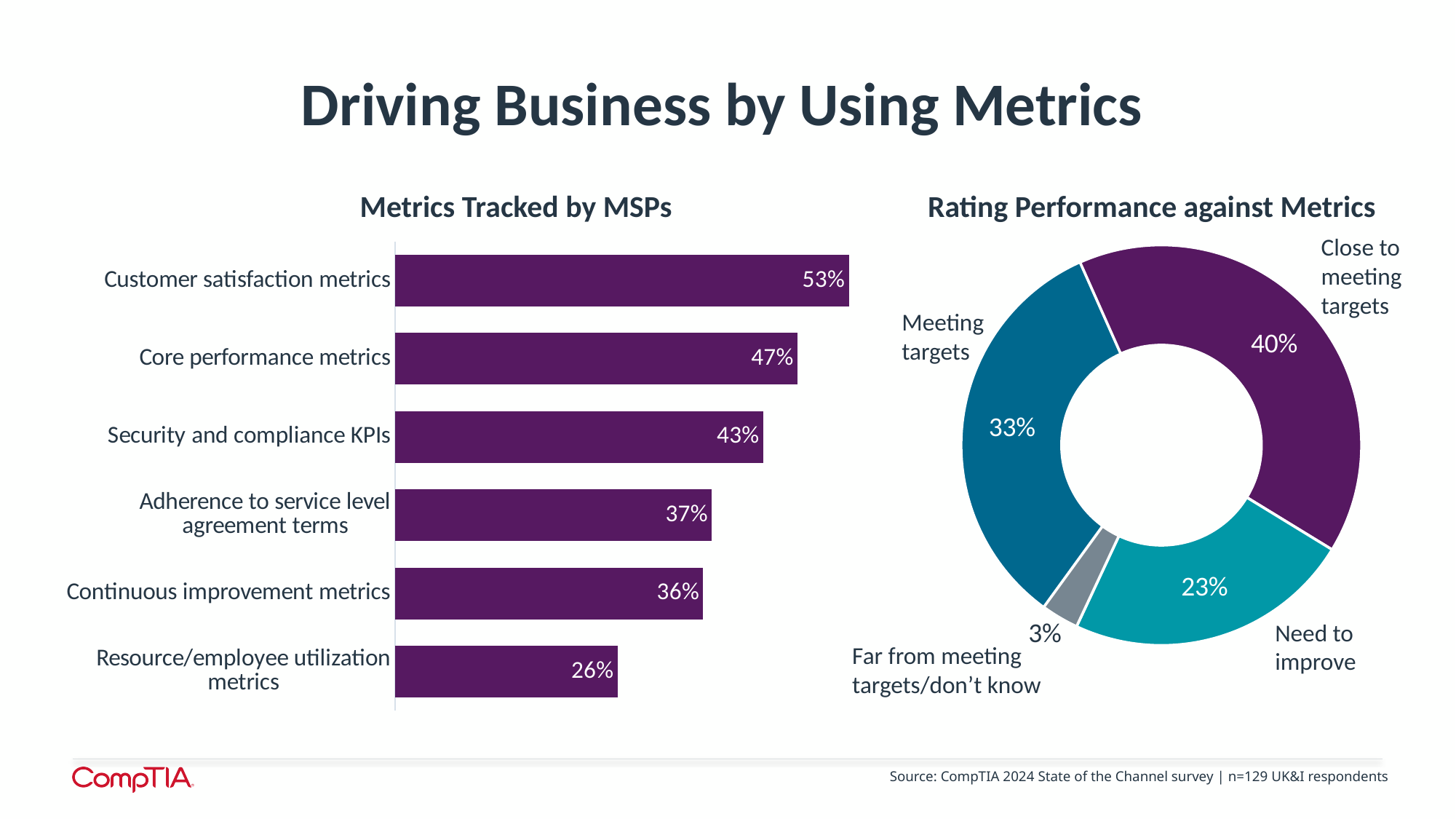
In the 'Rating Performance against Metrics' chart, what share is 'Meeting targets'? 33% In the 'Metrics Tracked by MSPs' chart, what is the value for Security and compliance KPIs? 43% What kind of chart is 'Metrics Tracked by MSPs'? Bar chart In the 'Metrics Tracked by MSPs' chart, which category has the highest value? Customer satisfaction metrics In the 'Rating Performance against Metrics' chart, which is larger: 'Meeting targets' or 'Need to improve'? Meeting targets In the 'Metrics Tracked by MSPs' chart, what is the difference between Core performance metrics and Continuous improvement metrics? 11% In the 'Rating Performance against Metrics' chart, which segment is the largest? Close to meeting targets In the 'Rating Performance against Metrics' chart, what is the value for 'Need to improve'? 23% What kind of chart is 'Rating Performance against Metrics'? Doughnut chart In the 'Metrics Tracked by MSPs' chart, which category has the lowest value? Resource/employee utilization metrics In the 'Metrics Tracked by MSPs' chart, how many categories are shown? 6 In the 'Metrics Tracked by MSPs' chart, what is the value for Customer satisfaction metrics? 53%